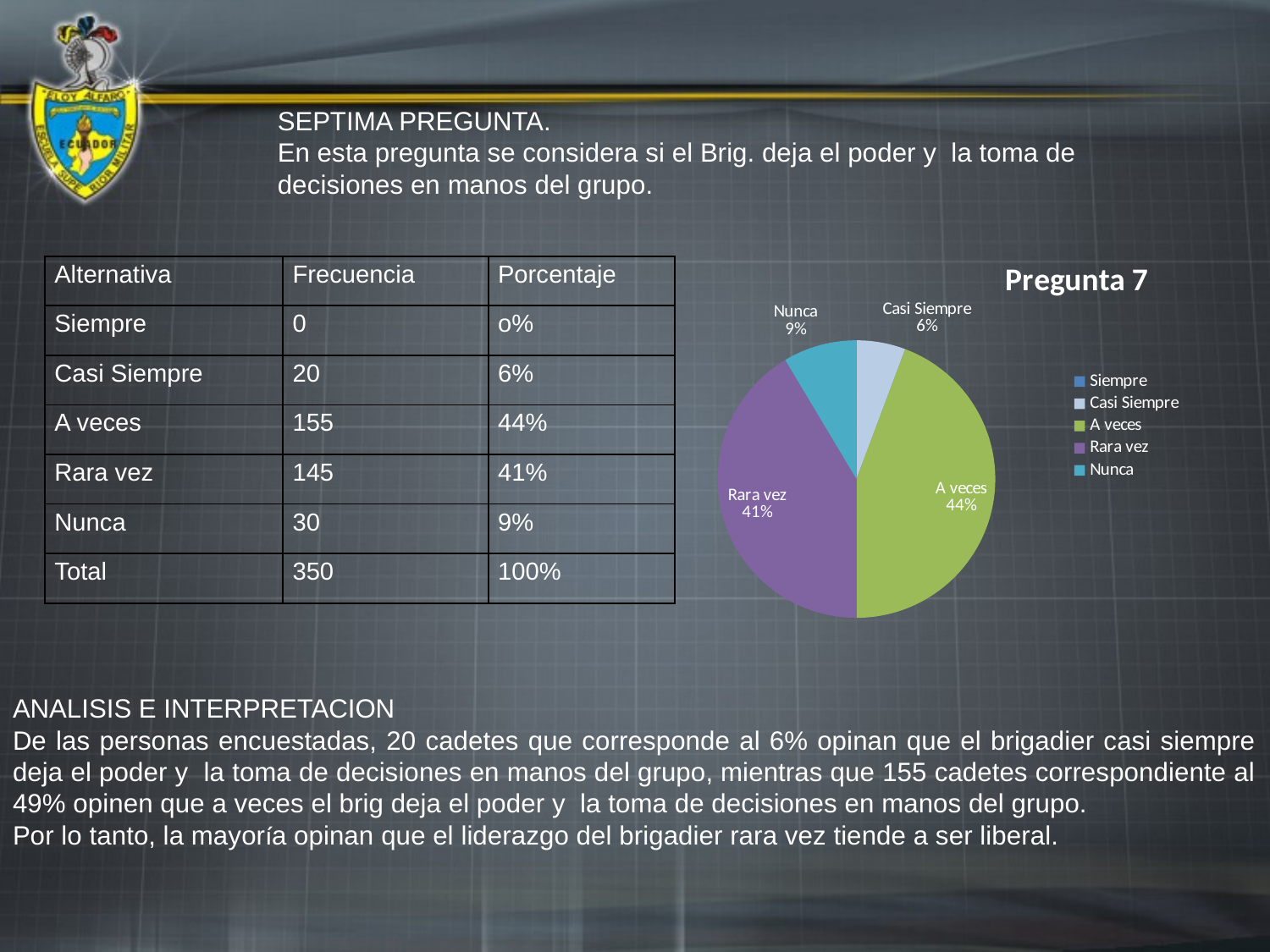
Which slice has the largest share of the pie? A veces What percentage does the 'Rara vez' slice show? 41% What percentage does the 'Nunca' slice show? 9% Which slice is larger, 'Nunca' or 'Casi Siempre'? Nunca How many entries does the chart legend list? 5 What percentage does the 'A veces' slice show? 44% What is the title of the chart? Pregunta 7 What colour is the 'A veces' slice in the pie chart? green What type of chart is shown on the slide? pie chart What percentage does the 'Casi Siempre' slice show? 6% What is the difference in percentage points between the 'A veces' and 'Rara vez' slices? 3 Among the slices with a percentage label on the pie, which has the smallest share? Casi Siempre